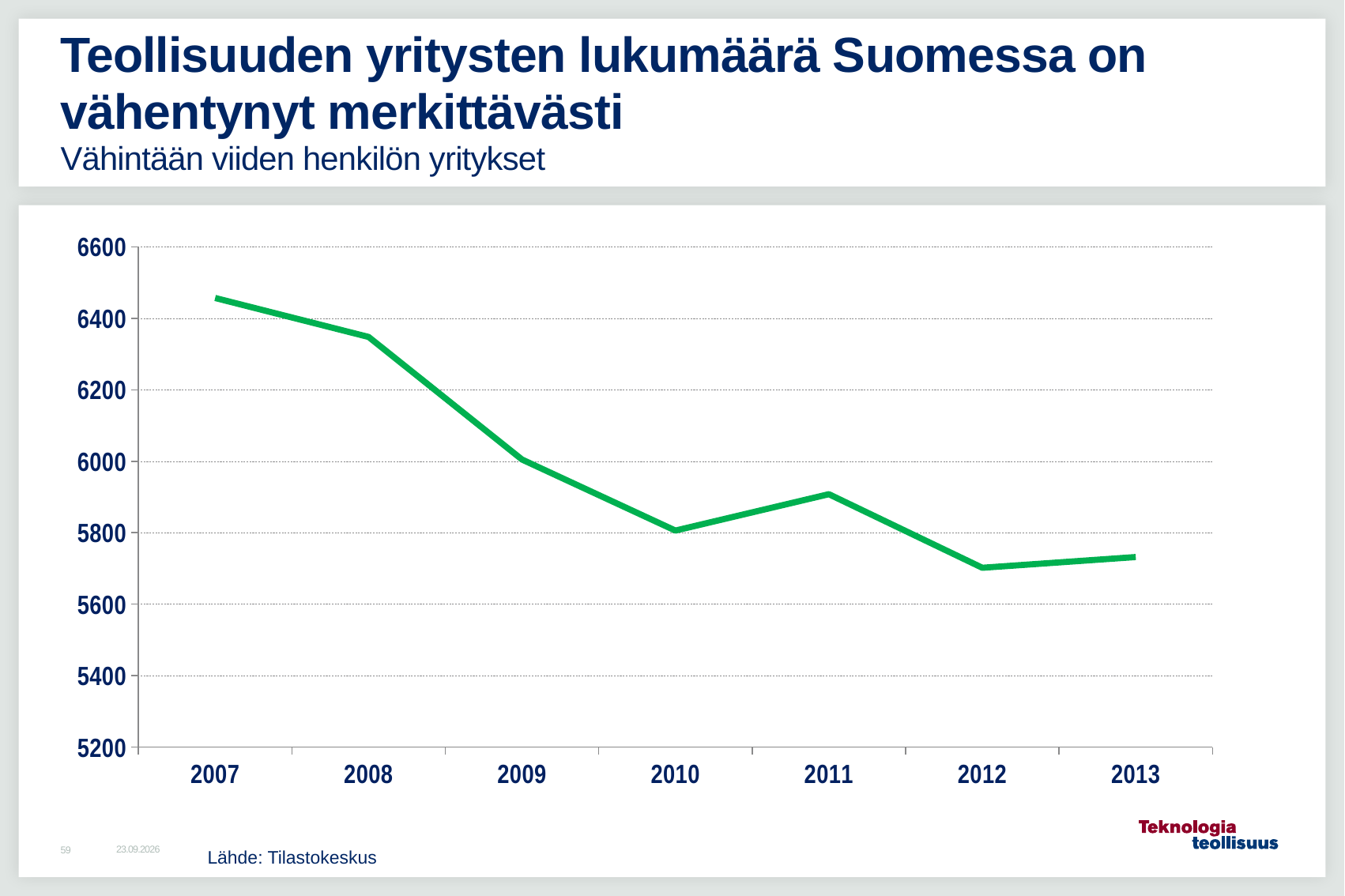
Is the value for 2007 greater or less than 6400? greater Is the value for 2012 greater or less than 5800? less What kind of chart is shown on the slide? line chart What source is cited for the chart data? Tilastokeskus Is the value for 2009 greater or less than 6200? less Which year has the highest value? 2007 Which year has the larger value, 2008 or 2009? 2008 Which year has the larger value, 2010 or 2011? 2011 How many years are plotted on the x axis? 7 Do the values generally rise or fall from 2007 to 2013? fall